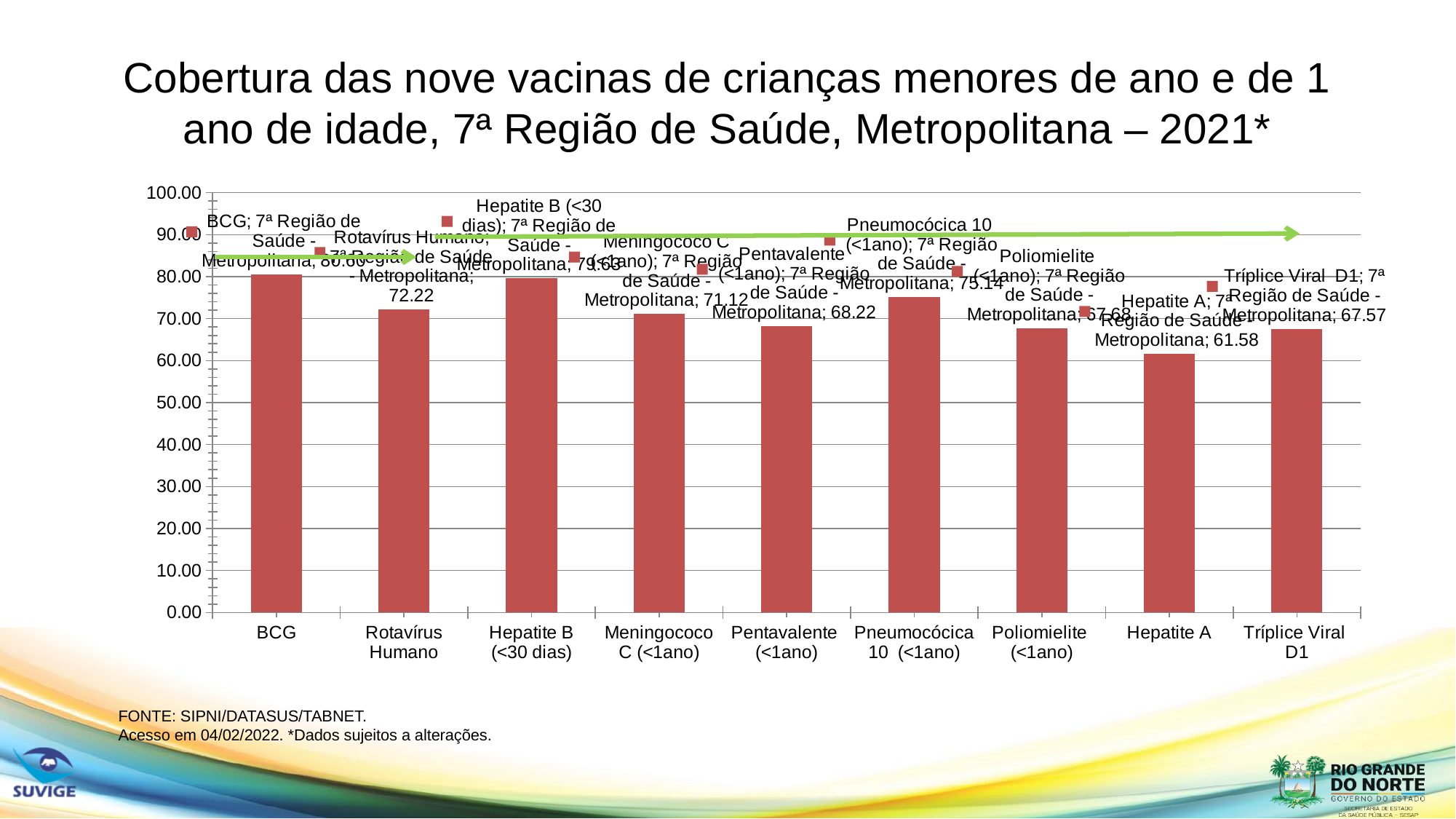
Is the value for Poliomielite (<1ano) greater or less than 70.00? less What is the value for Hepatite A? 61.58 What is the difference between the values for Rotavírus Humano and Hepatite A? 10.64 Which vaccine has the lowest coverage value? Hepatite A What is the difference between the values for Pneumocócica 10 (<1ano) and Pentavalente (<1ano)? 6.92 What is the value for Rotavírus Humano? 72.22 How many vaccines are shown on the x axis? 9 What is the value for Pneumocócica 10 (<1ano)? 75.14 What kind of chart is shown on the slide? bar chart What is the value for Tríplice Viral D1? 67.57 Which is larger, the value for Meningococo C (<1ano) or the value for Pentavalente (<1ano)? Meningococo C (<1ano) Is the value for BCG greater or less than 70.00? greater